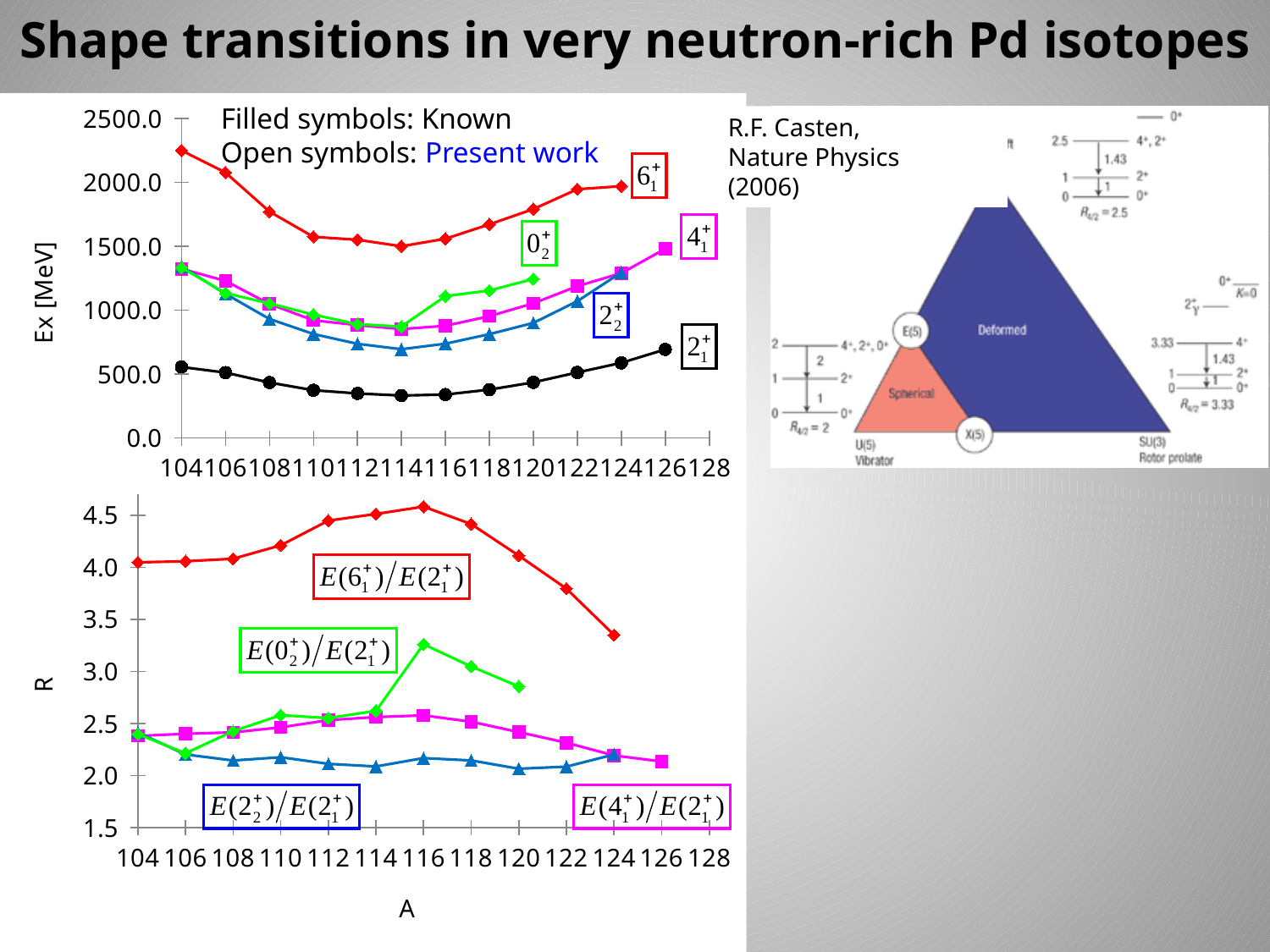
In the top chart, does the 2+1 series rise or fall from A = 104 to A = 114? fall In the bottom chart, at A = 116, which is larger: E(0+2)/E(2+1) or E(2+2)/E(2+1)? E(0+2)/E(2+1) What is the y-axis label of the top chart? Ex [MeV] In the top chart, how many data points does the 2+1 (black circle) series have? 12 In the top chart, which series has the lowest excitation energies across all A? 2+1 In the top chart, is the value of the 6+1 series at A = 104 greater or less than 2000.0? greater In the bottom chart (R versus A), is the value of E(6+1)/E(2+1) at A = 116 greater or less than 4.5? greater In the bottom chart, does the E(6+1)/E(2+1) series rise or fall from A = 116 to A = 124? fall What kind of chart is the top chart (Ex [MeV] versus A)? line chart In the top chart, is the value of the 2+1 series at A = 114 greater or less than 500.0? less In the top chart, which series has the highest excitation energies across all A? 6+1